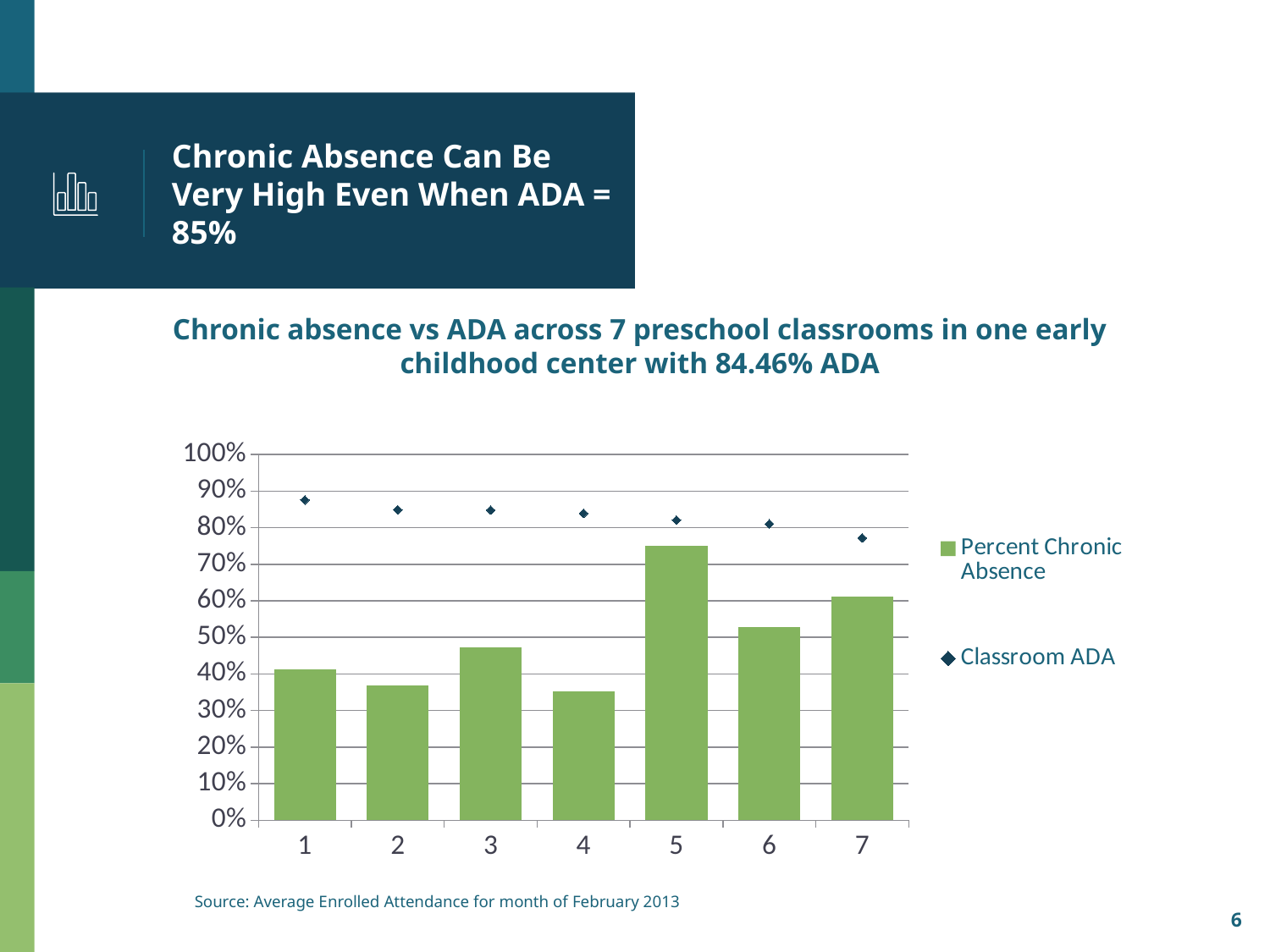
Which classroom has the highest Percent Chronic Absence? 5 How many series does the legend list? 2 Is the Percent Chronic Absence for classroom 5 greater or less than 70%? greater What kind of chart is shown on the slide? bar chart Which classroom has the lowest Classroom ADA? 7 Is the Classroom ADA for classroom 7 greater or less than 80%? less Which is larger, the Percent Chronic Absence for classroom 7 or for classroom 6? classroom 7 Which classroom has the highest Classroom ADA? 1 Is the Percent Chronic Absence for classroom 4 greater or less than 40%? less How many classrooms are shown on the x axis? 7 What is the overall ADA stated in the chart title? 84.46% Does the Classroom ADA rise or fall from classroom 1 to classroom 7? fall